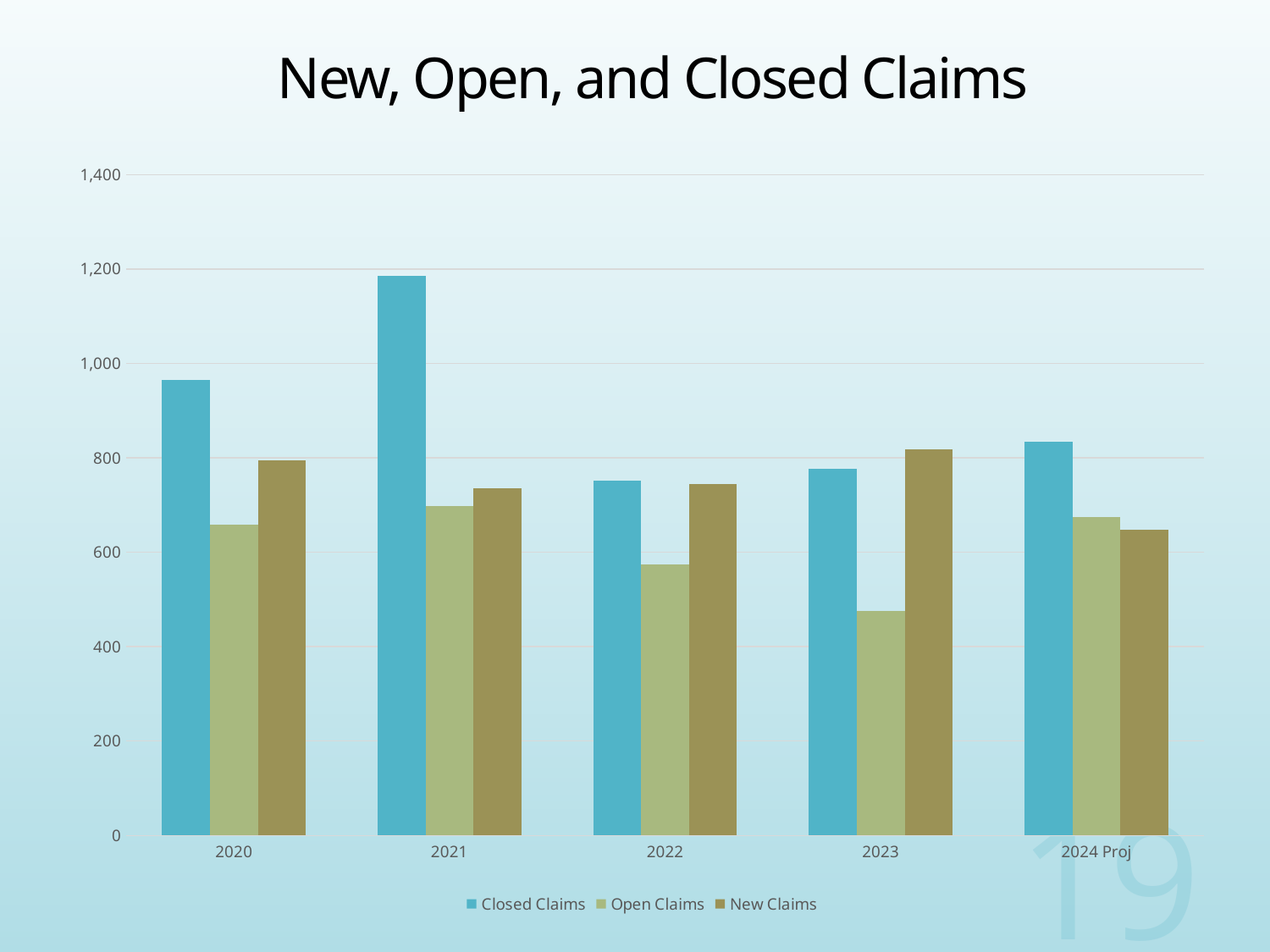
In 2023, which is larger: New Claims or Open Claims? New Claims Is the value for Closed Claims in 2020 greater or less than 1,000? less In which year are Closed Claims highest? 2021 What is the title of the chart? New, Open, and Closed Claims How many year categories are shown on the x axis? 5 How many series does the legend list? 3 Is the value for Open Claims in 2023 greater or less than 600? less Do Open Claims rise or fall from 2021 to 2023? fall Is the value for Closed Claims in 2021 greater or less than 1,000? greater In which year are Open Claims lowest? 2023 What kind of chart is shown on the slide? bar chart